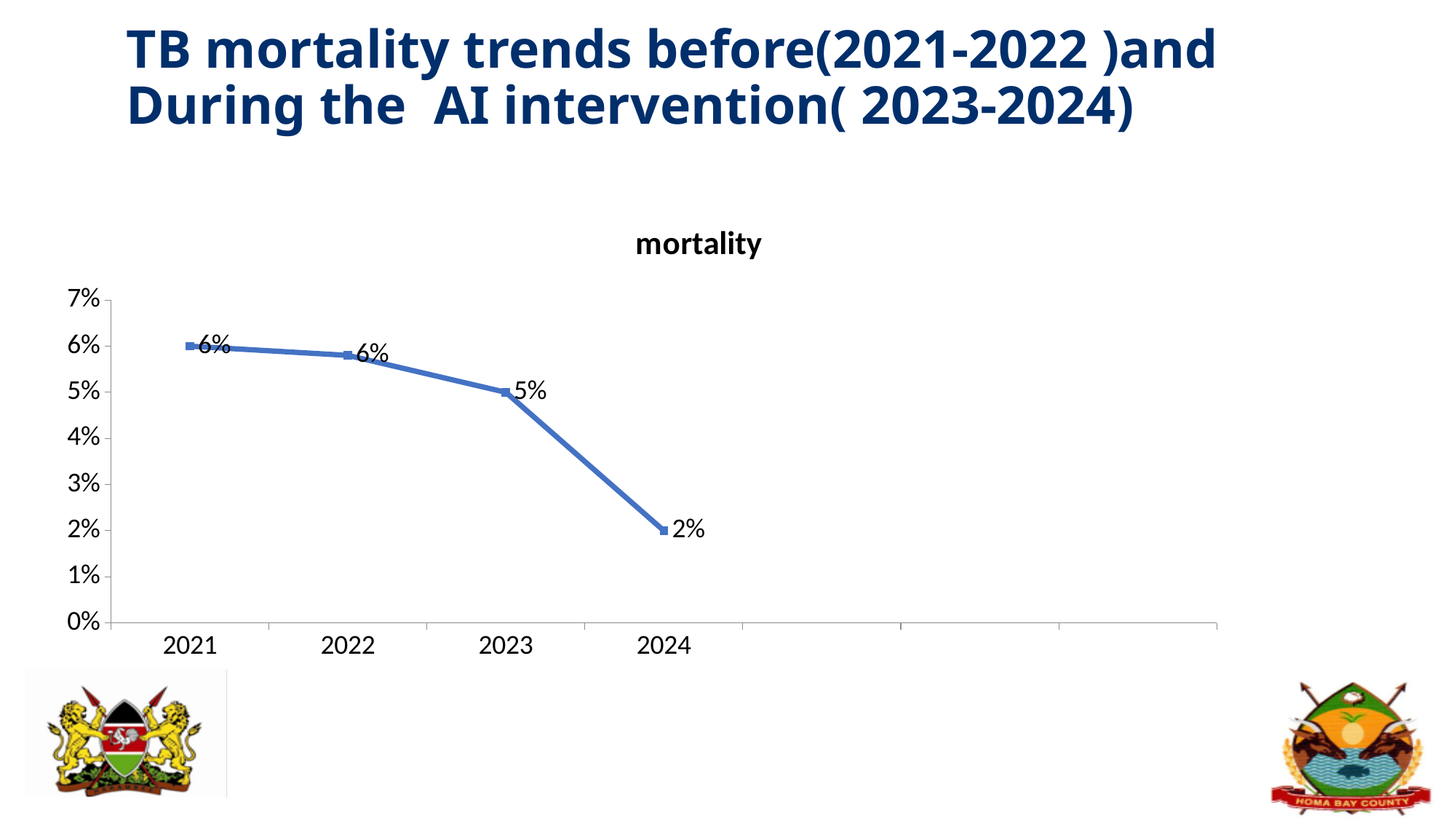
What is the mortality value for 2024? 2% What is the mortality value for 2021? 6% Which year has the lowest mortality value? 2024 How many years are plotted on the chart? 4 What is the mortality value for 2023? 5% What is the difference between the mortality values for 2023 and 2024? 3% What is the title of the chart? mortality What kind of chart is shown on the slide? line chart What is the difference between the mortality values for 2021 and 2024? 4% Do the mortality values rise or fall from 2021 to 2024? fall Is the mortality value for 2024 greater or less than 3%? less Which is larger, the mortality value for 2023 or for 2024? 2023